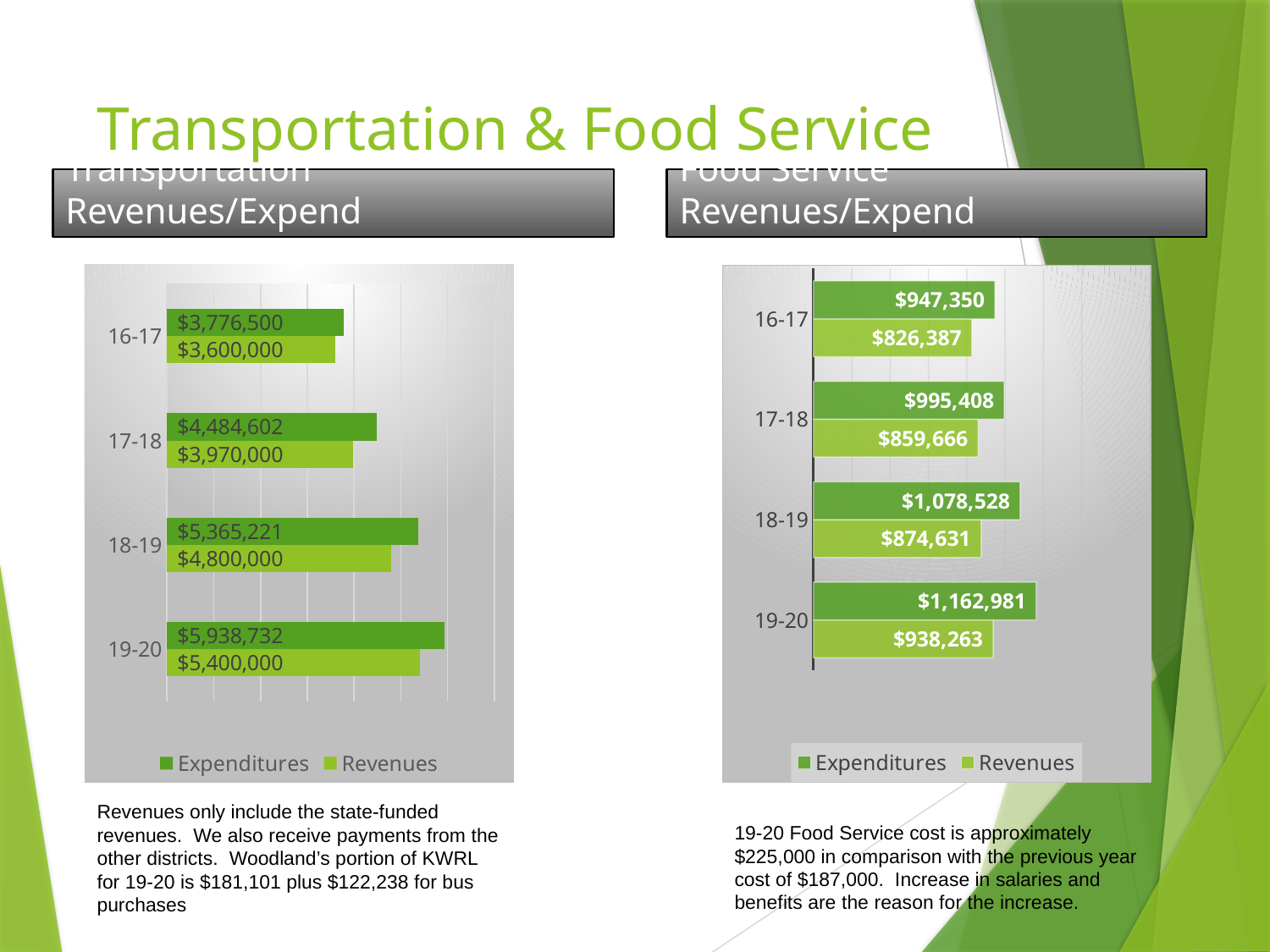
In the Food Service Revenues/Expend chart, which is larger for 17-18, Expenditures or Revenues? Expenditures How many series does the legend of the Food Service Revenues/Expend chart list? 2 In the Transportation Revenues/Expend chart, what are the Revenues for 17-18? $3,970,000 In the Transportation Revenues/Expend chart, what are the Expenditures for 19-20? $5,938,732 In the Transportation Revenues/Expend chart, what is the difference between Expenditures and Revenues for 19-20? $538,732 In the Transportation Revenues/Expend chart, which year has the highest Expenditures? 19-20 What type of chart is the Transportation Revenues/Expend chart? Bar chart In the Food Service Revenues/Expend chart, what are the Revenues for 16-17? $826,387 In the Food Service Revenues/Expend chart, what is the difference between Expenditures and Revenues for 19-20? $224,718 In the Food Service Revenues/Expend chart, which year has the lowest Revenues? 16-17 How many years are shown in the Transportation Revenues/Expend chart? 4 In the Food Service Revenues/Expend chart, what are the Expenditures for 18-19? $1,078,528